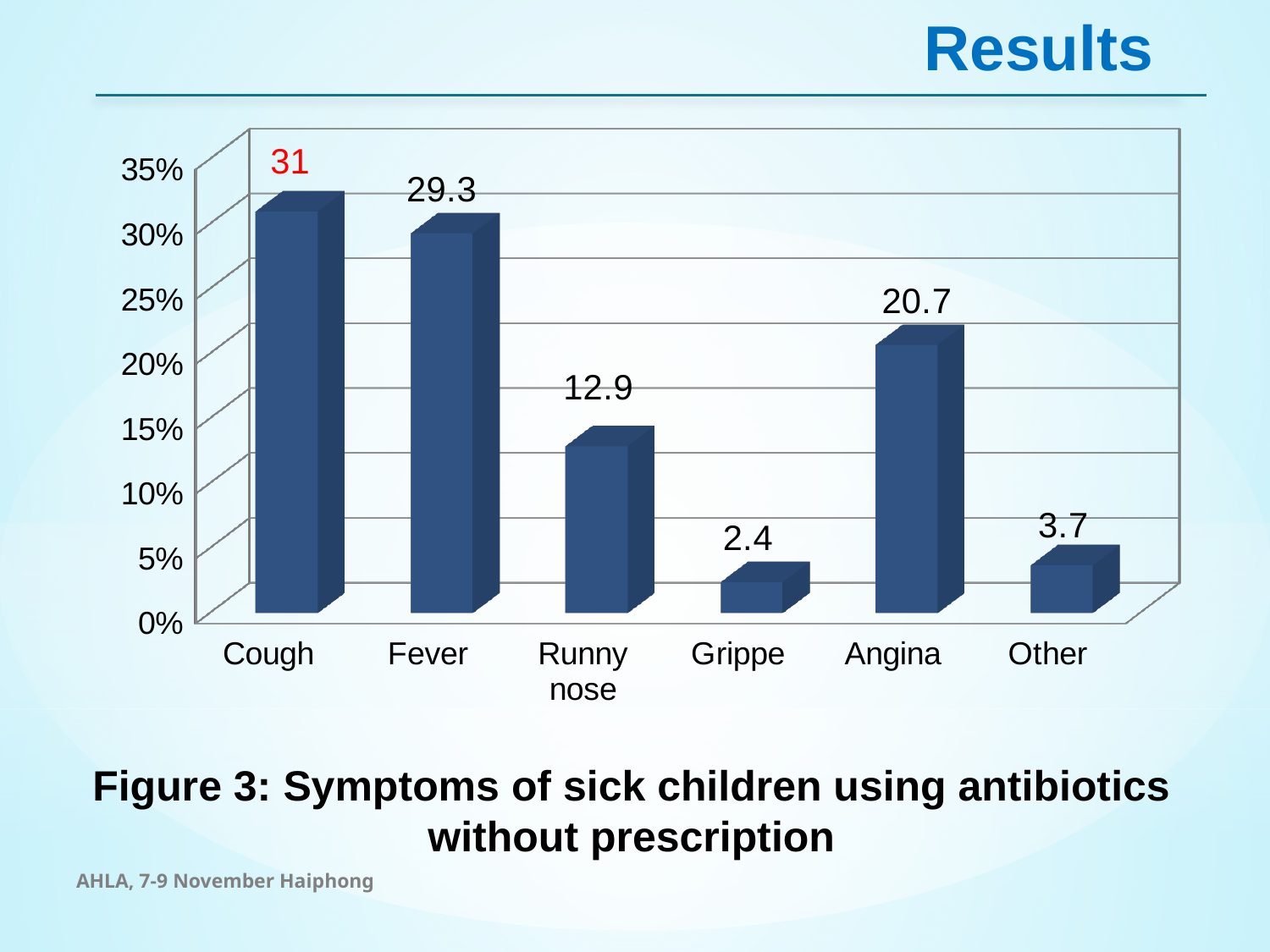
What is the value for Angina? 20.7 What kind of chart is shown on the slide? Bar chart Which is larger, the value for Angina or the value for Runny nose? Angina Which symptom has the highest value? Cough What is the value for Runny nose? 12.9 What is the difference between the values for Cough and Fever? 1.7 How many symptom categories are shown on the x axis? 6 What is the value for Cough? 31 What is the value for Fever? 29.3 Which symptom has the lowest value? Grippe What is the value for Grippe? 2.4 What is the caption of the figure below the chart? Figure 3: Symptoms of sick children using antibiotics without prescription